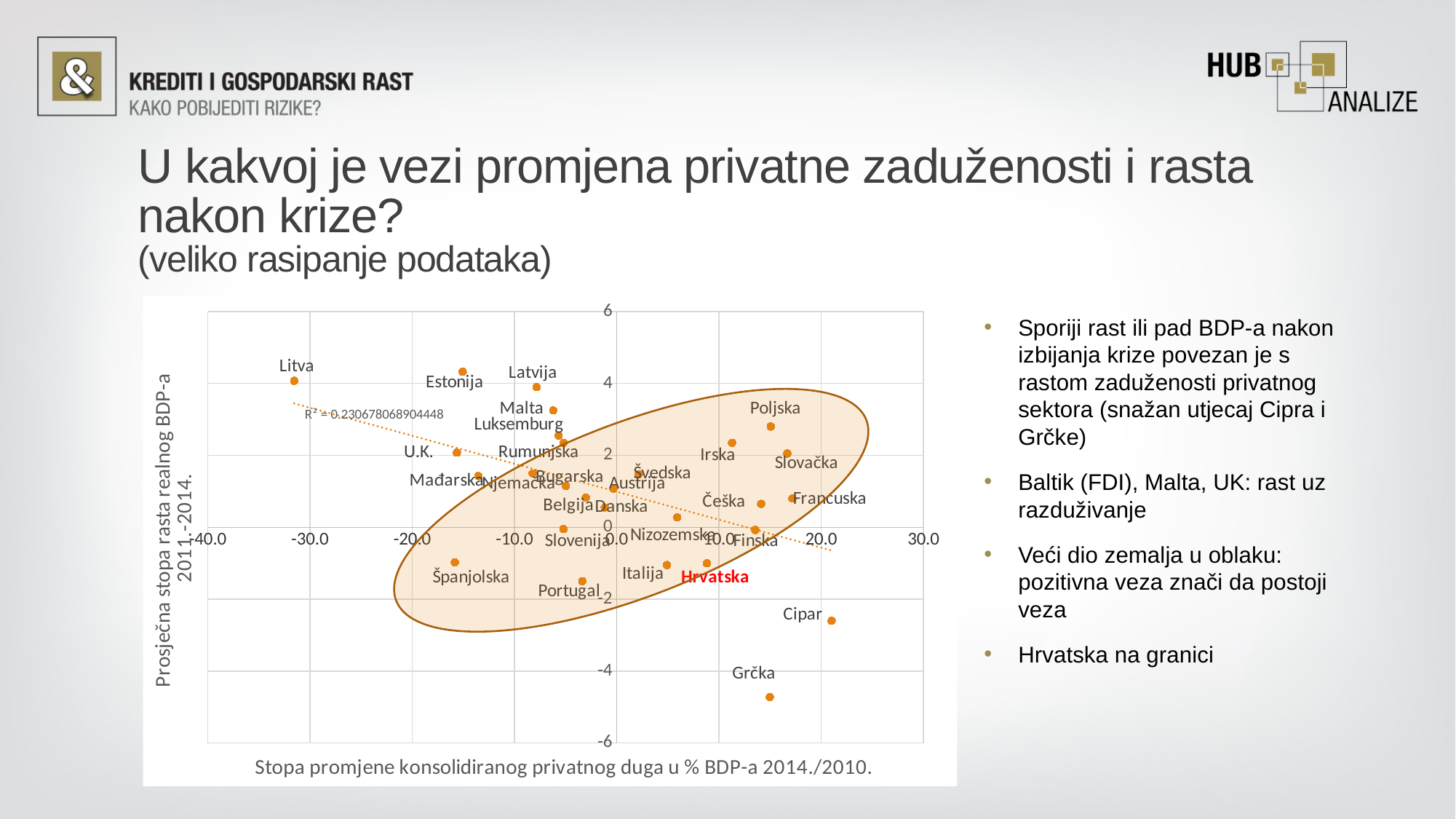
Is the vertical-axis value for Poljska greater or less than 2? greater Is the vertical-axis value for Hrvatska greater or less than 0? less Which has the lower vertical-axis value, Grčka or Cipar? Grčka What kind of chart is shown on the slide? scatter chart Which country label on the chart is shown in red? Hrvatska Is the vertical-axis value for Grčka greater or less than -4? less Which country is plotted furthest to the left on the horizontal axis? Litva What R² value is printed on the chart? R² = 0.230678068904448 Which country is plotted furthest to the right on the horizontal axis? Cipar Which country has the lowest value on the vertical axis (Prosječna stopa rasta realnog BDP-a 2011.-2014.)? Grčka Which has the higher vertical-axis value, Poljska or Hrvatska? Poljska